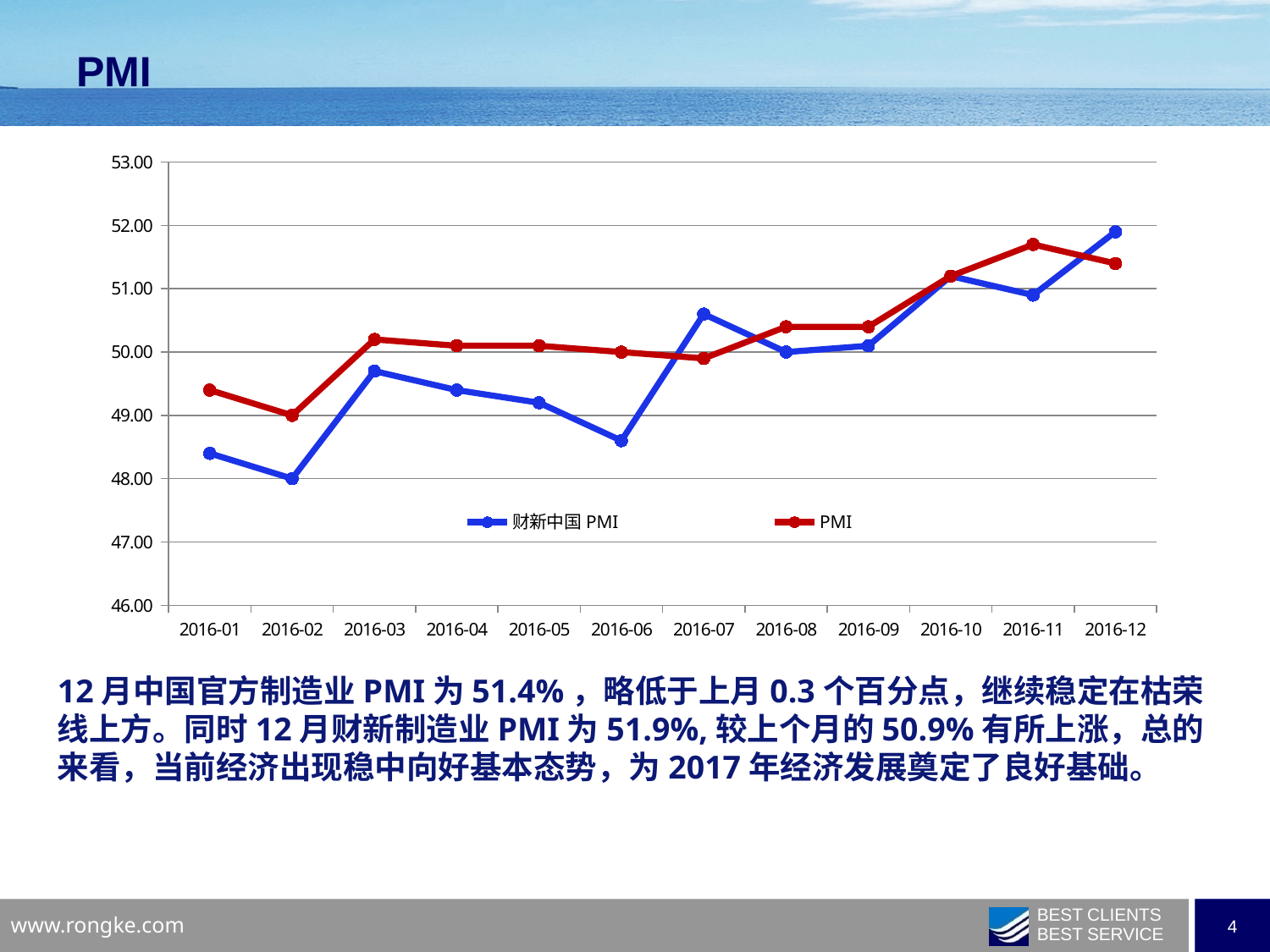
How many months are plotted along the x axis? 12 Is the 财新中国 PMI value for 2016-12 greater or less than 51.00? greater In which month does the PMI series reach its lowest value? 2016-02 In which month does the PMI series reach its highest value? 2016-11 In 2016-07, which series has the larger value, 财新中国 PMI or PMI? 财新中国 PMI What kind of chart is shown on the slide? line chart In which month does the 财新中国 PMI series reach its lowest value? 2016-02 Overall, do the PMI values rise or fall from 2016-01 to 2016-12? rise How many series does the legend list? 2 In which month does the 财新中国 PMI series reach its highest value? 2016-12 Is the 财新中国 PMI value for 2016-01 greater or less than 49.00? less Is the PMI value for 2016-11 greater or less than 51.00? greater